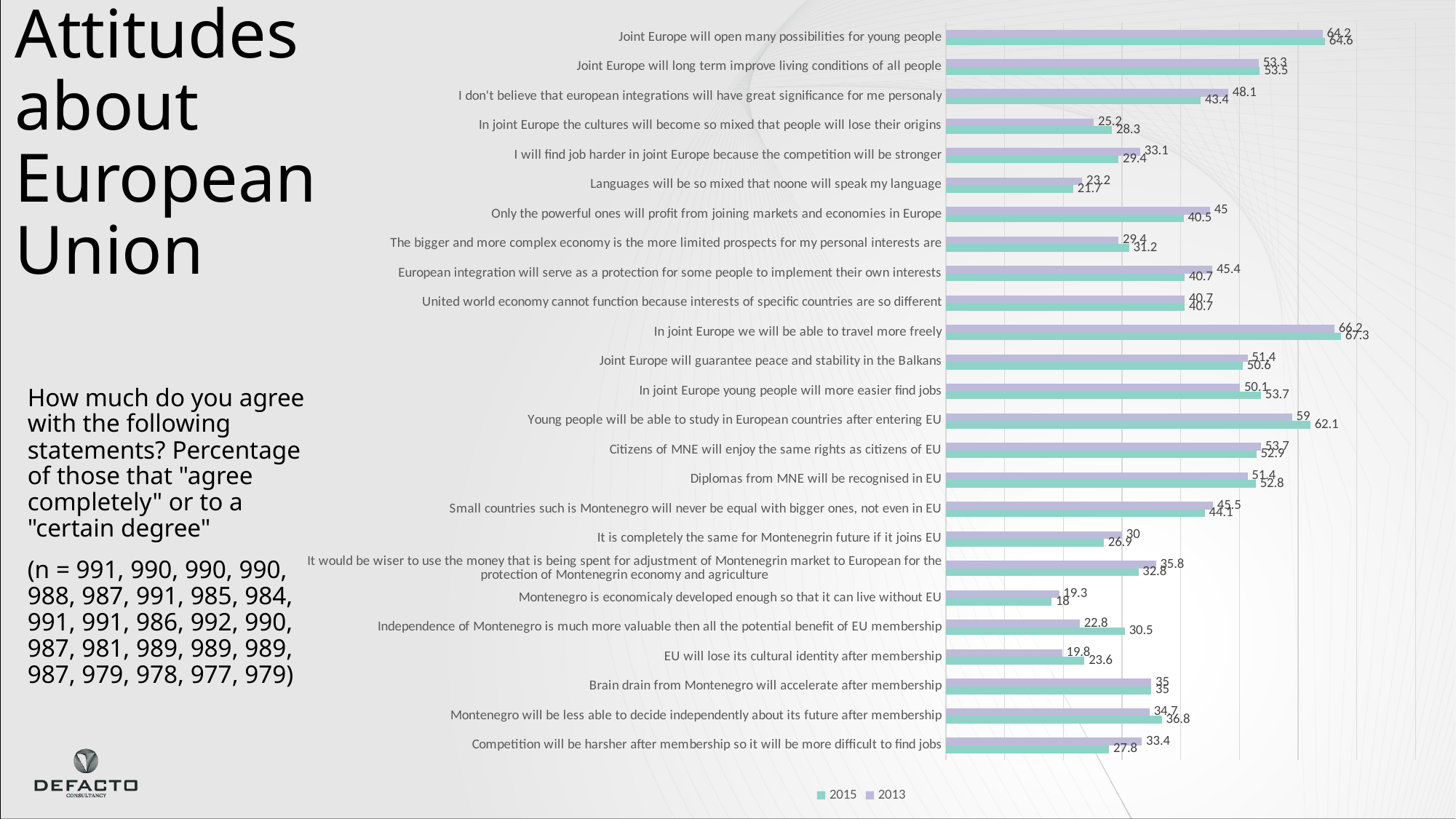
Which statement has the lowest 2015 value? Montenegro is economicaly developed enough so that it can live without EU What kind of chart is shown on the slide? bar chart How many statements (categories) are plotted in the chart? 25 For "EU will lose its cultural identity after membership", which year has the larger value, 2013 or 2015? 2015 How many series does the legend list? 2 For "Competition will be harsher after membership so it will be more difficult to find jobs", which year has the larger value, 2013 or 2015? 2013 Which statement has the highest 2015 value? In joint Europe we will be able to travel more freely Which series is shown in purple according to the legend? 2013 What is the 2013 value for "Young people will be able to study in European countries after entering EU"? 59 What is the 2015 value for "In joint Europe we will be able to travel more freely"? 67.3 What is the 2015 value for "Independence of Montenegro is much more valuable then all the potential benefit of EU membership"? 30.5 What is the difference between the 2013 and 2015 values for "I don't believe that european integrations will have great significance for me personaly"? 4.7